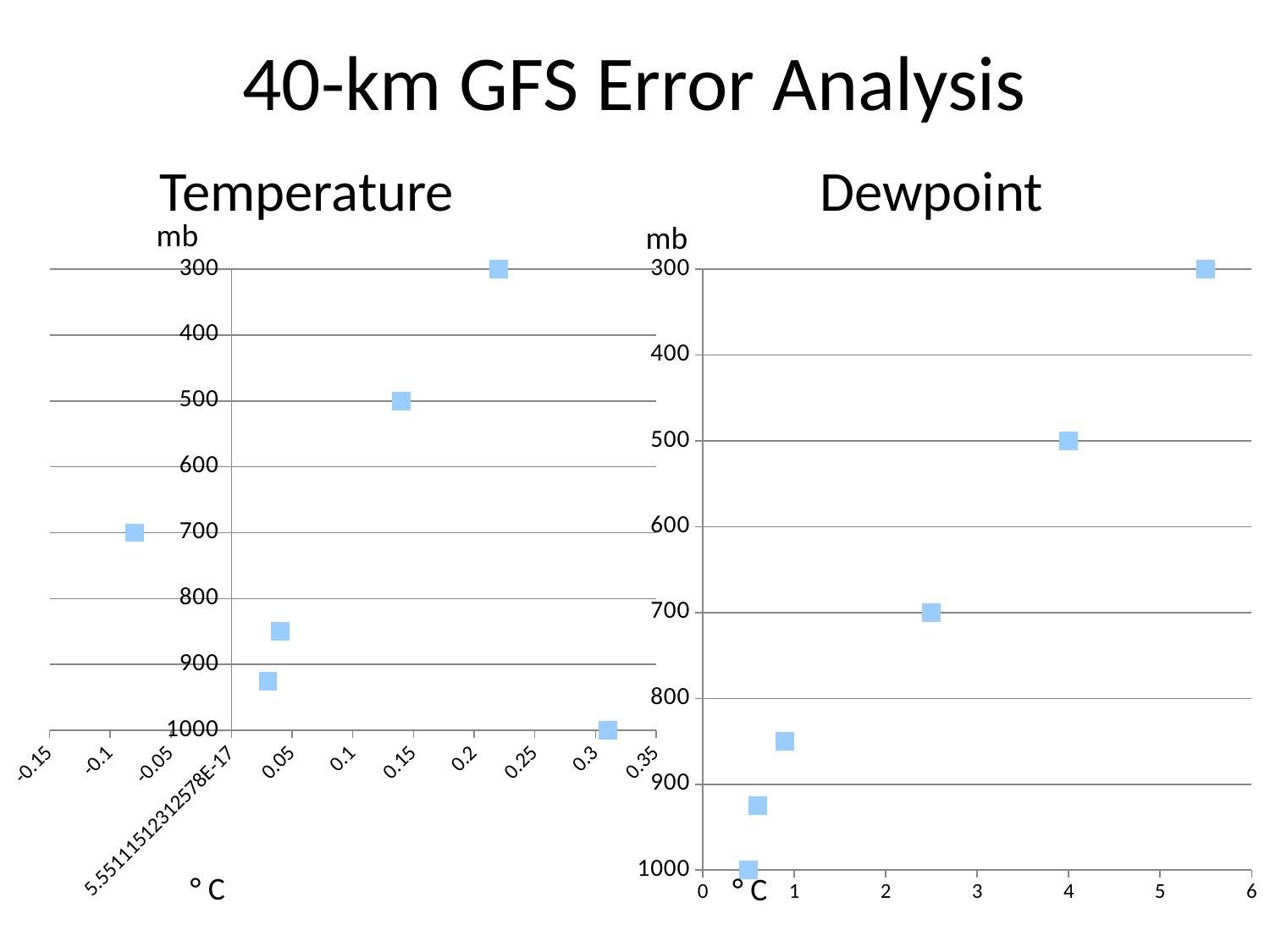
What kind of chart is the Temperature chart? scatter chart How many data points are plotted in the Dewpoint chart? 6 How many data points are plotted in the Temperature chart? 6 What unit is shown on the x axis of the Dewpoint chart? ° C In the Dewpoint chart, is the error value at 300 mb greater or less than 5? greater In the Temperature chart, at which pressure level is the error smallest? 700 mb In the Temperature chart, is the error value at 1000 mb greater or less than 0.25? greater In the Temperature chart, is the error value at 700 mb greater or less than 0? less In the Dewpoint chart, which has the larger error: the point at 500 mb or the point at 700 mb? 500 mb In the Temperature chart, at which pressure level is the error largest? 1000 mb In the Dewpoint chart, at which pressure level is the error largest? 300 mb